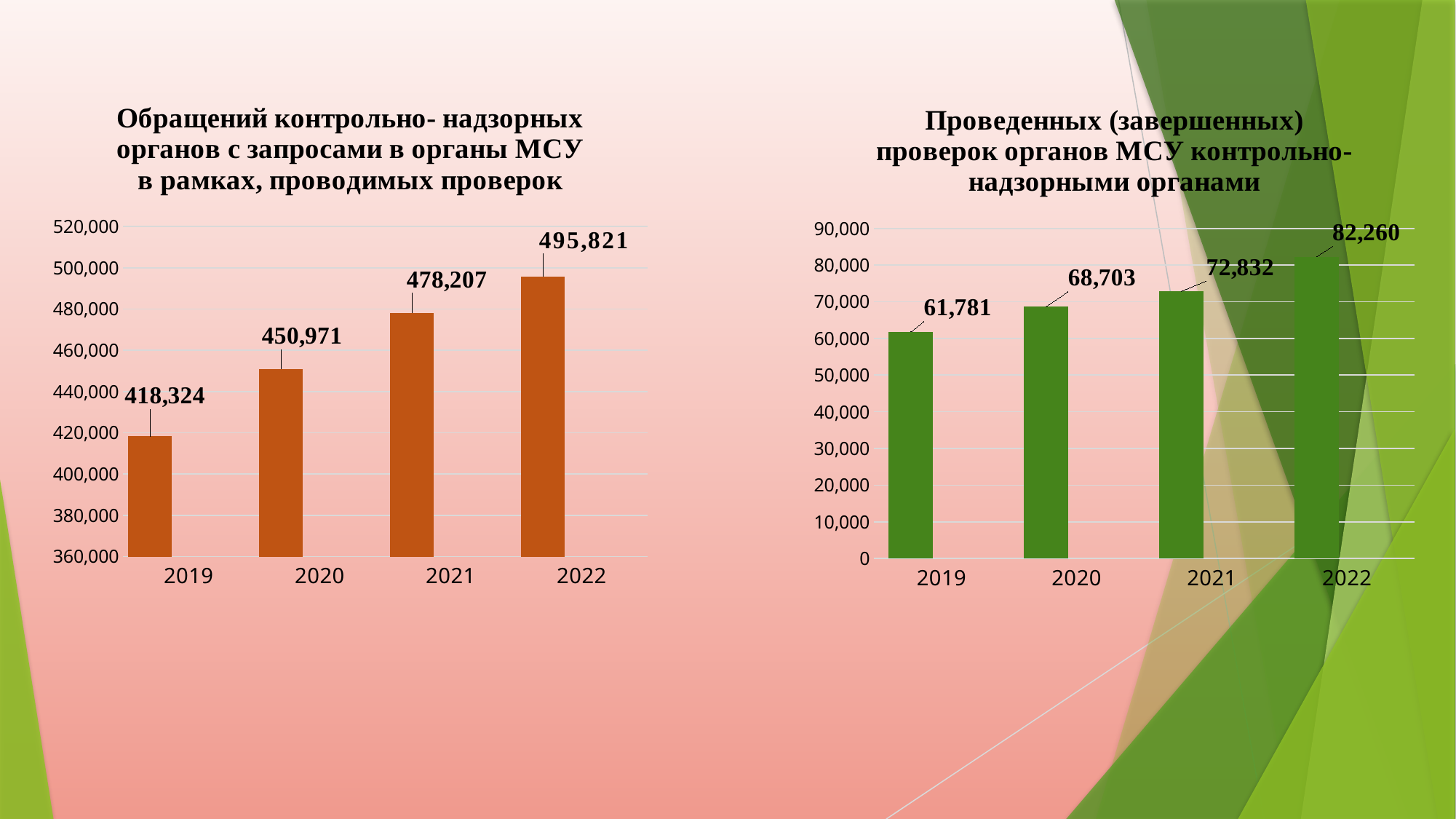
In the left chart (Обращений контрольно-надзорных органов...), what is the difference between the 2022 and 2019 values? 77,497 In the left chart (Обращений контрольно-надзорных органов...), which year has the highest value? 2022 Do the values in the left chart (Обращений контрольно-надзорных органов...) rise or fall from 2019 to 2022? rise In the left chart (Обращений контрольно-надзорных органов...), what is the value for 2019? 418,324 In the left chart (Обращений контрольно-надзорных органов...), is the value for 2020 greater or less than 460,000? less In the right chart (Проведенных (завершенных) проверок...), which is larger, the value for 2019 or the value for 2021? 2021 In the right chart (Проведенных (завершенных) проверок...), what is the value for 2020? 68,703 In the right chart (Проведенных (завершенных) проверок...), which year has the lowest value? 2019 How many years are shown on the x axis of the right chart (Проведенных (завершенных) проверок...)? 4 In the right chart (Проведенных (завершенных) проверок...), what is the value for 2022? 82,260 In the right chart (Проведенных (завершенных) проверок...), what is the difference between the 2021 and 2020 values? 4,129 In the left chart (Обращений контрольно-надзорных органов...), what is the value for 2021? 478,207